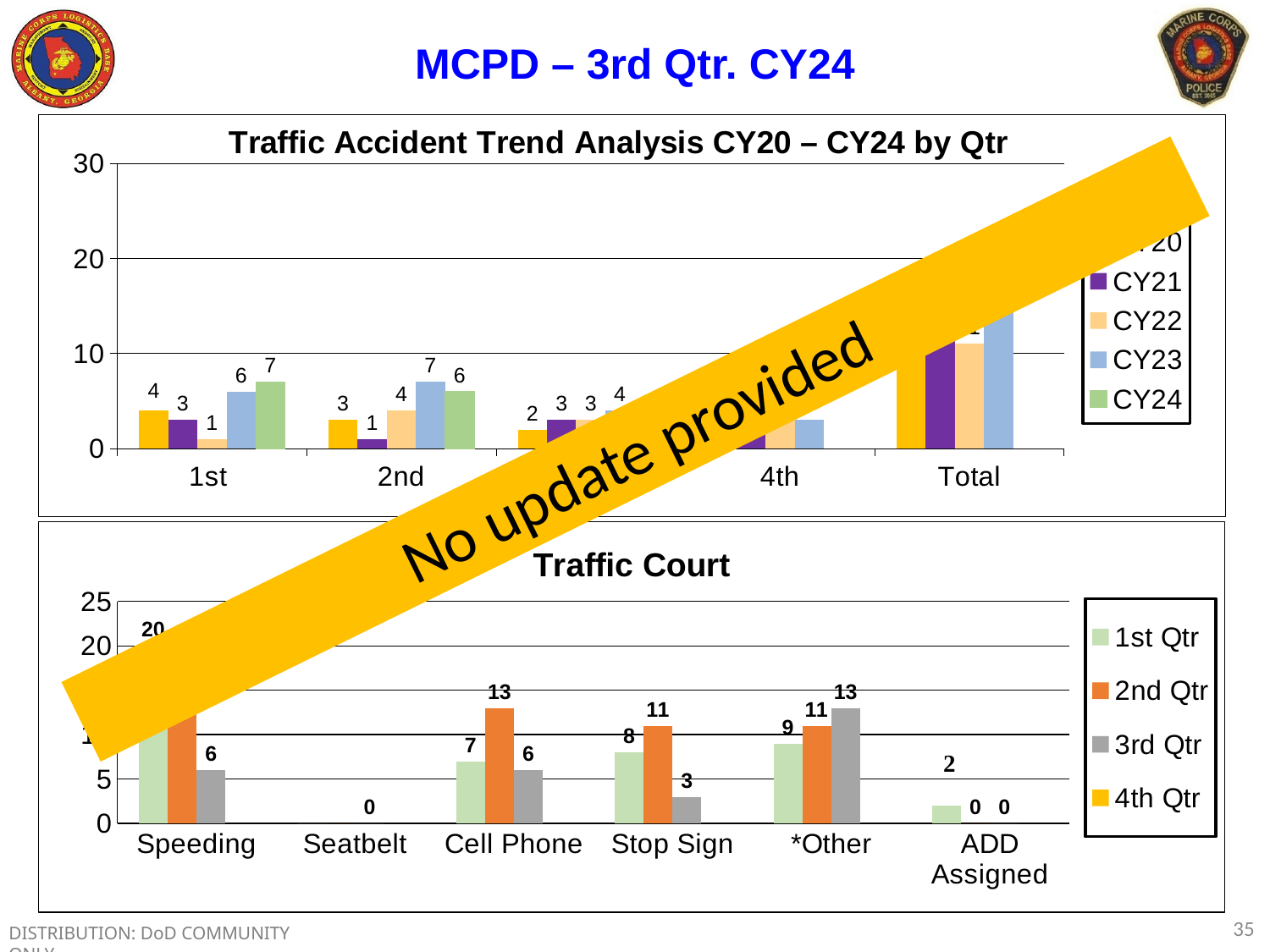
In the Traffic Court chart, what is the 2nd Qtr value for Cell Phone? 13 In the Traffic Court chart, what is the 3rd Qtr value for *Other? 13 In the Traffic Court chart, how many series does the legend list? 4 In the Traffic Accident Trend Analysis chart, what is the CY24 value for the 1st quarter? 7 In the Traffic Court chart, which is larger for Cell Phone: the 1st Qtr value or the 3rd Qtr value? 1st Qtr In the Traffic Court chart, what is the 1st Qtr value for Speeding? 20 In the Traffic Court chart, what is the difference between the 2nd Qtr and 3rd Qtr values for Stop Sign? 8 In the Traffic Court chart, how many categories are shown on the x axis? 6 In the Traffic Court chart, what is the 3rd Qtr value for Stop Sign? 3 What kind of chart is the Traffic Court chart? Bar chart In the Traffic Accident Trend Analysis chart, what is the CY23 value for the 2nd quarter? 7 In the Traffic Accident Trend Analysis chart, which year has the lowest value in the 2nd quarter? CY21